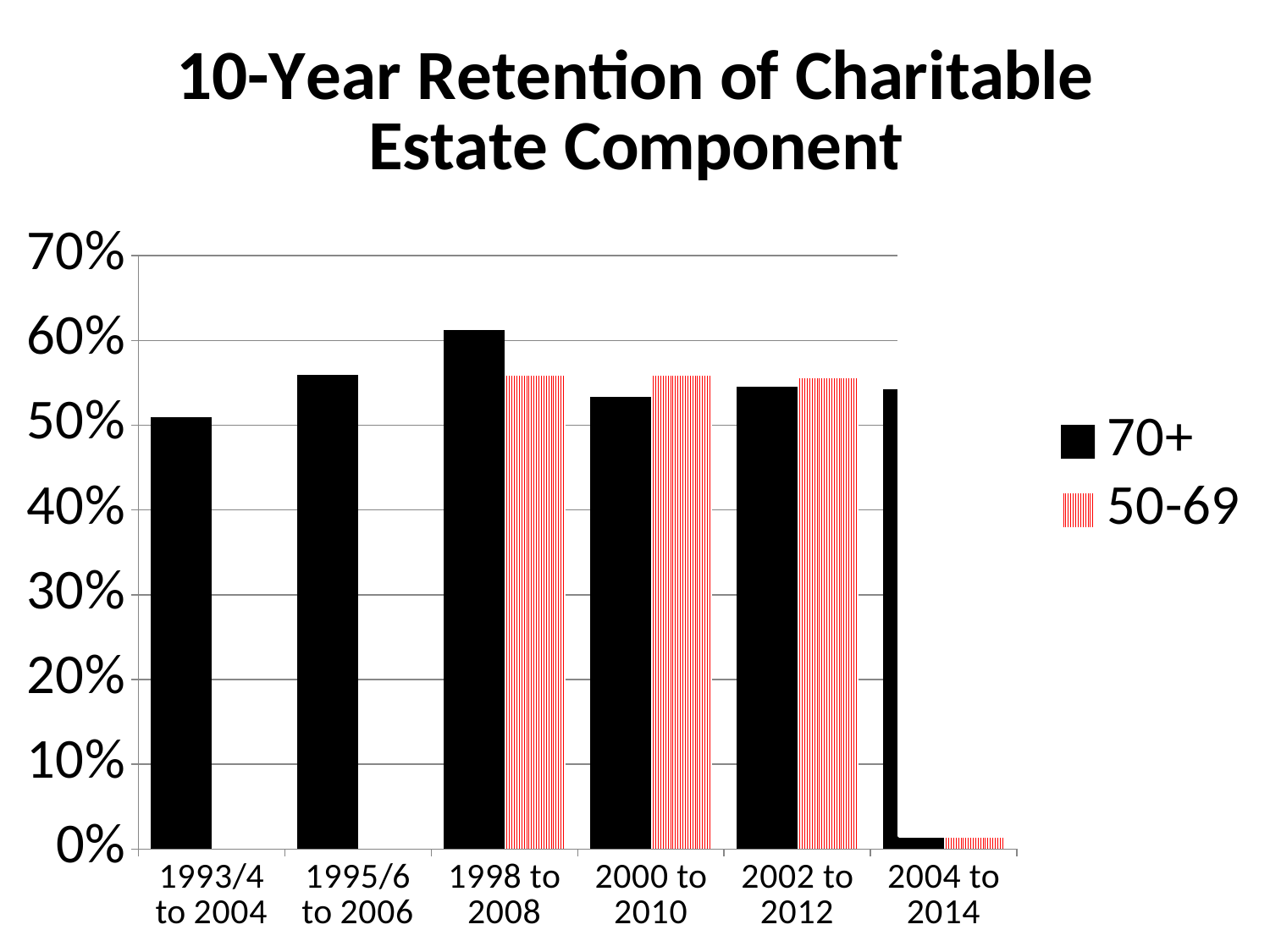
What is the title of the chart? 10-Year Retention of Charitable Estate Component How many time-period categories are shown on the x axis? 6 What kind of chart is shown on the slide? bar chart Is the 70+ value for 1995/6 to 2006 greater or less than 50%? greater For 1998 to 2008, which series has the larger value, 70+ or 50-69? 70+ Which series is shown with solid black bars? 70+ How many series does the legend list? 2 Which period has the highest value for the 70+ series? 1998 to 2008 For 2000 to 2010, which series has the larger value, 70+ or 50-69? 50-69 Is the 70+ value for 1998 to 2008 greater or less than 70%? less Is the 50-69 value for 1998 to 2008 greater or less than 50%? greater